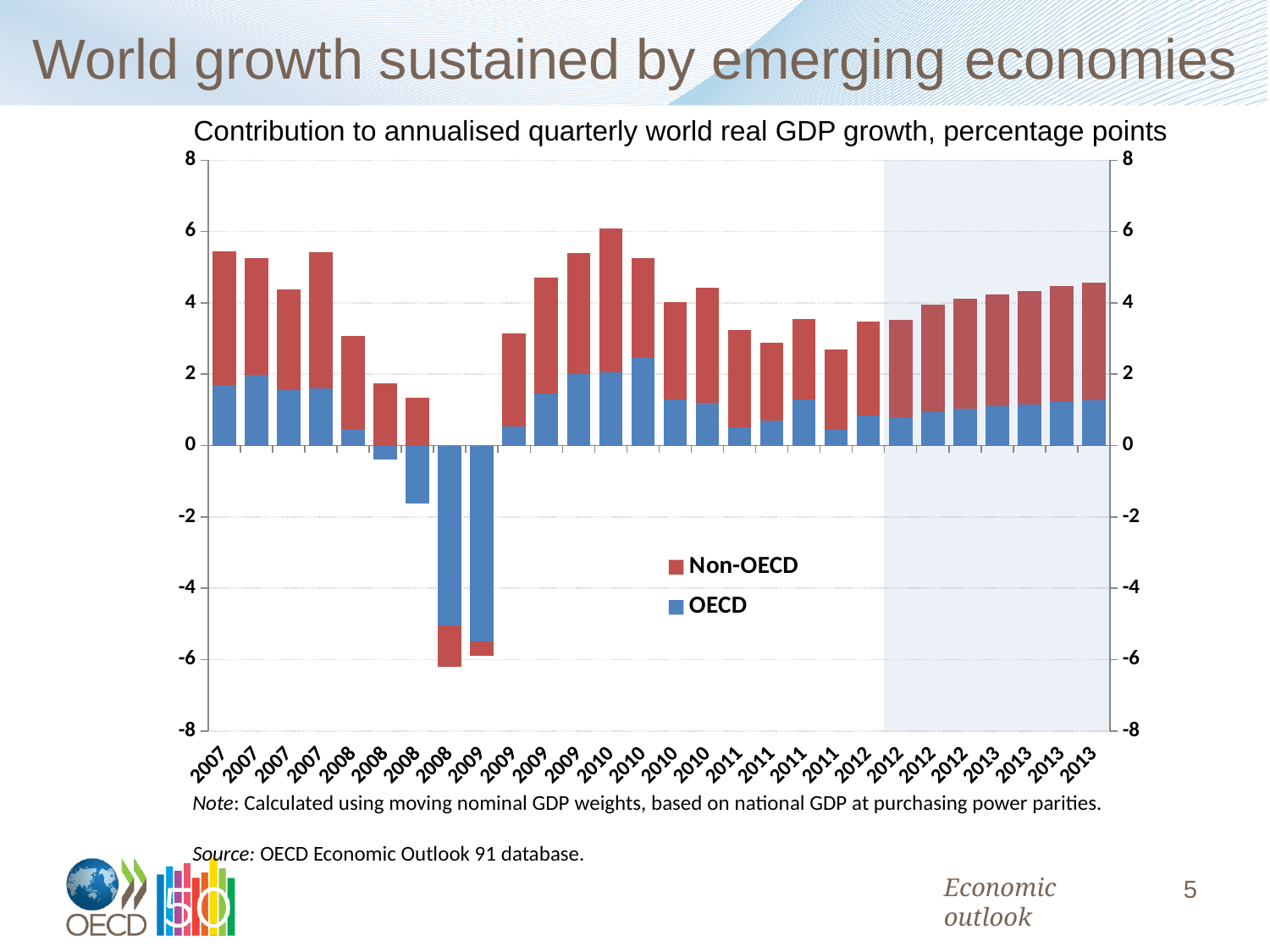
What kind of chart is shown on the slide? Stacked bar chart From the first 2007 bar to the last 2008 bar, do the total bar heights rise or fall? Fall Which colour represents the OECD series? Blue How many series does the legend list? 2 What are the two series named in the legend? Non-OECD and OECD In the shaded 2012–2013 period, do the total bar heights rise or fall from left to right? Rise Is the OECD contribution in the last 2013 bar greater or less than 2? less In the 2013 bars, which series contributes more, Non-OECD or OECD? Non-OECD How many bars are plotted along the x axis? 28 In the tallest bar (the first 2010 bar), which series has the larger contribution, Non-OECD or OECD? Non-OECD Is the total height of the last 2013 bar greater or less than 4? greater